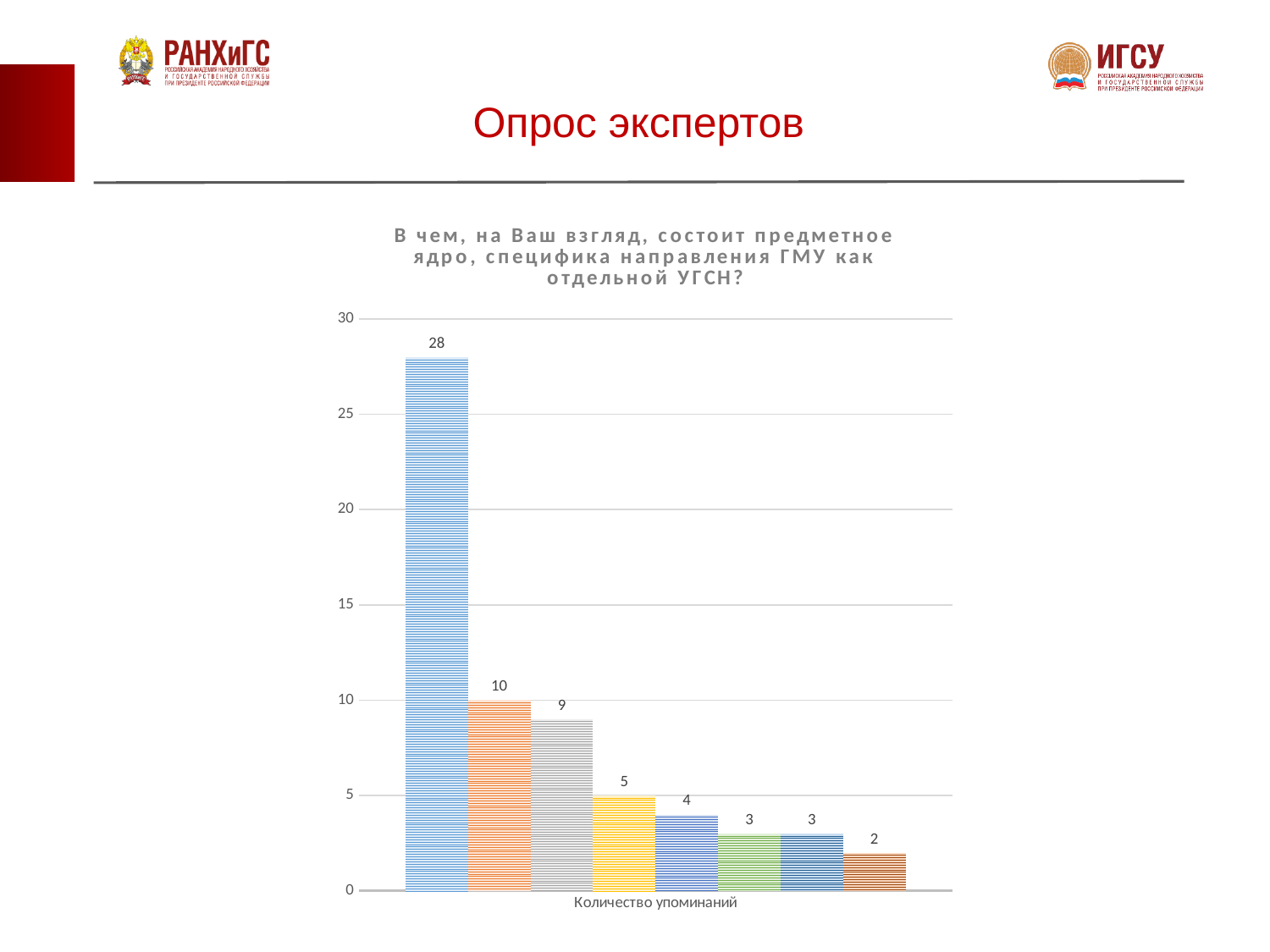
What is the value of the tallest bar in the chart? 28 What is the title of the chart? В чем, на Ваш взгляд, состоит предметное ядро, специфика направления ГМУ как отдельной УГСН? How many bars are plotted in the chart? 8 What is the value of the third bar from the left (grey)? 9 What is the difference between the tallest bar (28) and the second tallest bar (10)? 18 What is the label shown on the x axis under the bars? Количество упоминаний What is the value of the shortest bar in the chart? 2 What is the value of the second bar from the left (orange)? 10 Which is larger: the orange bar on the left (10) or the grey bar (9)? the orange bar (10) Is the value of the tallest bar greater or less than 25? greater What kind of chart is shown on the slide? bar chart What is the value of the yellow bar? 5